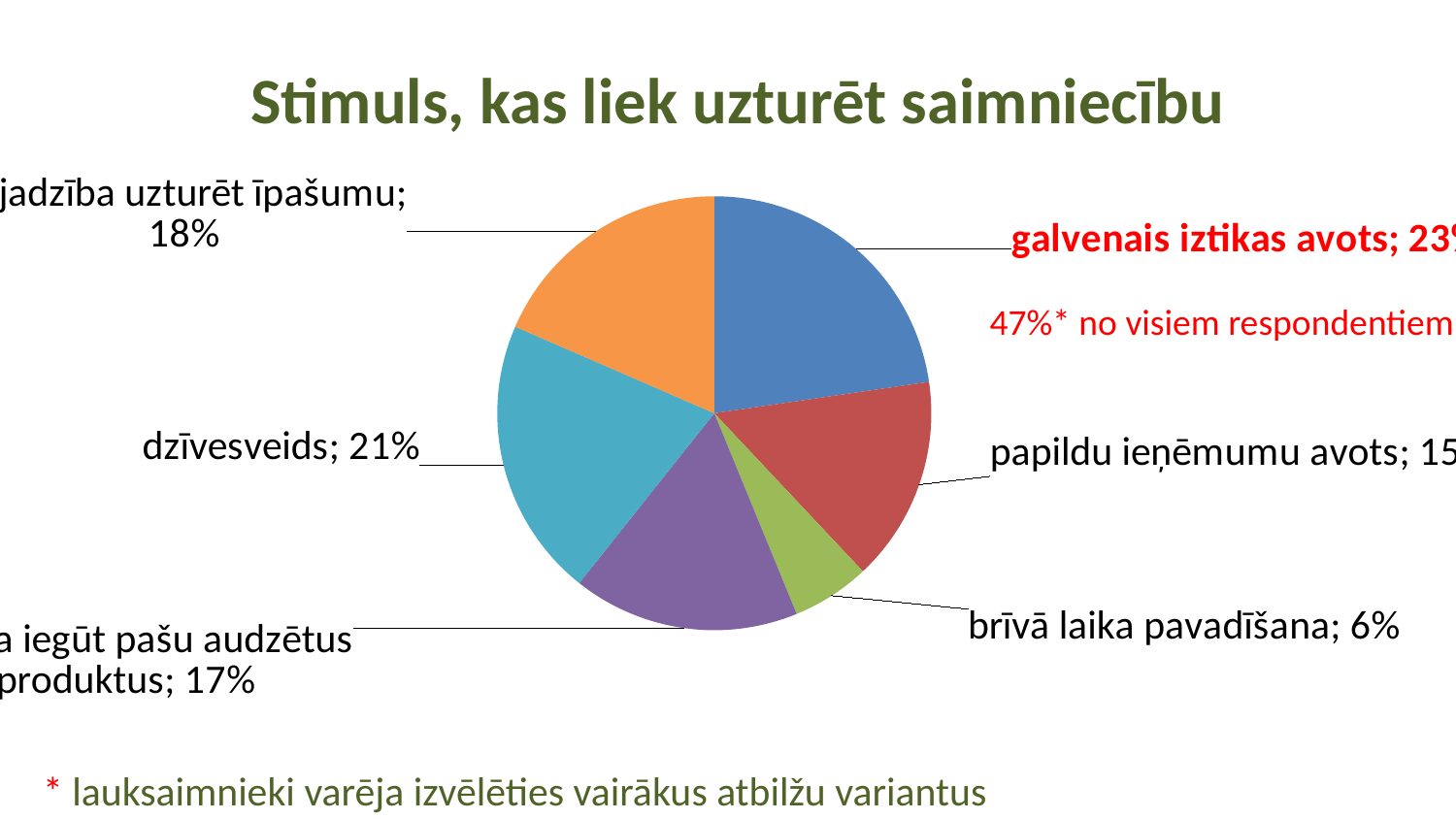
How many slices does the pie chart have? 6 What is the title of the chart? Stimuls, kas liek uzturēt saimniecību Which is larger, the slice for "dzīvesveids" or the slice for "brīvā laika pavadīšana"? dzīvesveids Which slice of the pie is the smallest? brīvā laika pavadīšana By how many percentage points does the "dzīvesveids" slice exceed the "brīvā laika pavadīšana" slice? 15 percentage points What colour is the slice for "brīvā laika pavadīšana"? green Which slice of the pie is the largest? galvenais iztikas avots What share of the pie is labelled "dzīvesveids"? 21% What kind of chart is shown on the slide? pie chart What share of the pie is labelled "brīvā laika pavadīšana"? 6%